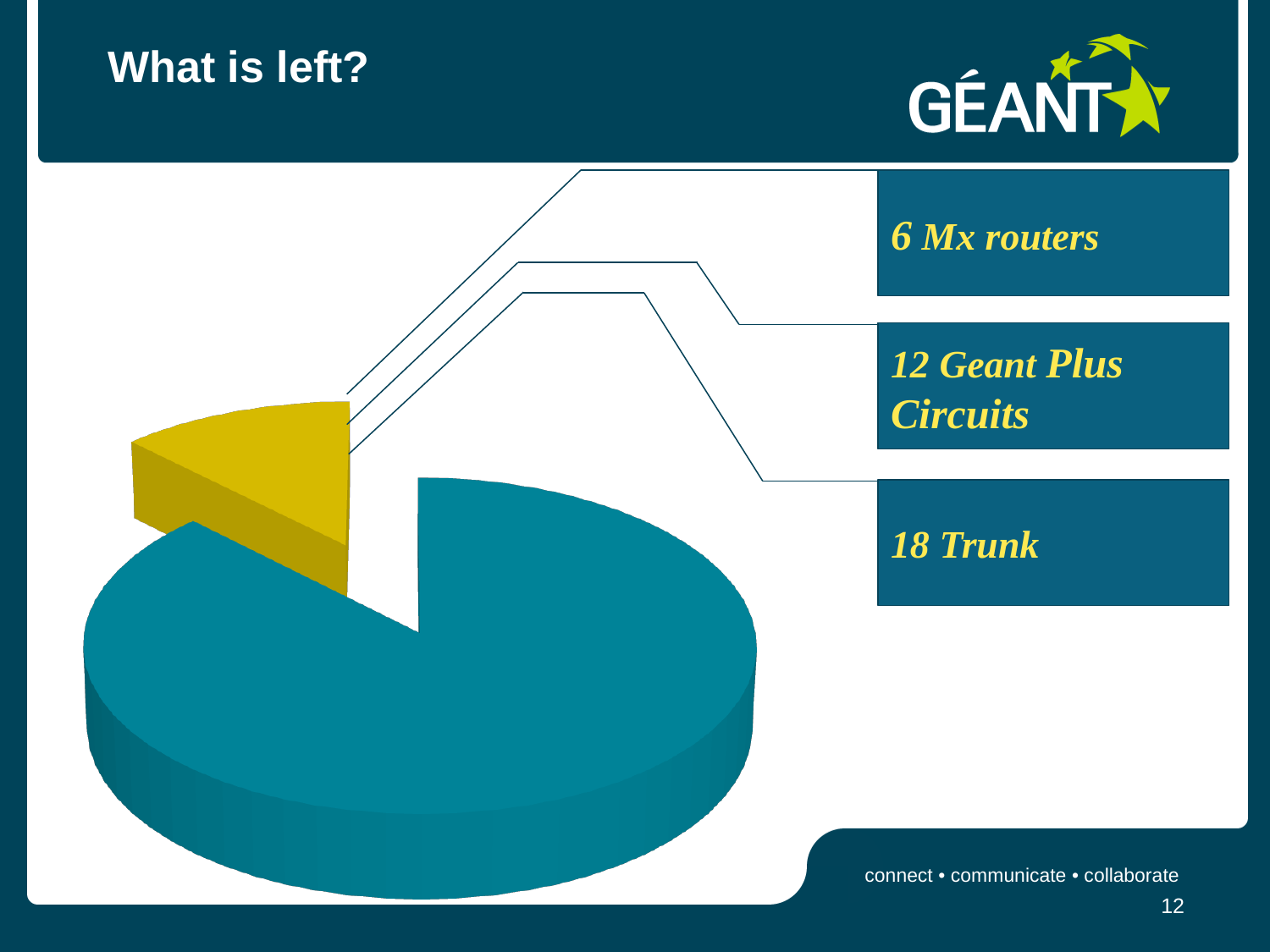
How many slices does the pie chart have? 2 Which colour slice represents the largest share of the pie chart? teal What kind of chart is shown on the slide? pie chart Which slice of the pie chart is pulled out (exploded) from the rest of the pie? the yellow slice Which slice of the pie chart is larger, the teal slice or the yellow slice? the teal slice Which colour slice represents the smallest share of the pie chart? yellow What is the title of the slide containing the pie chart? What is left?